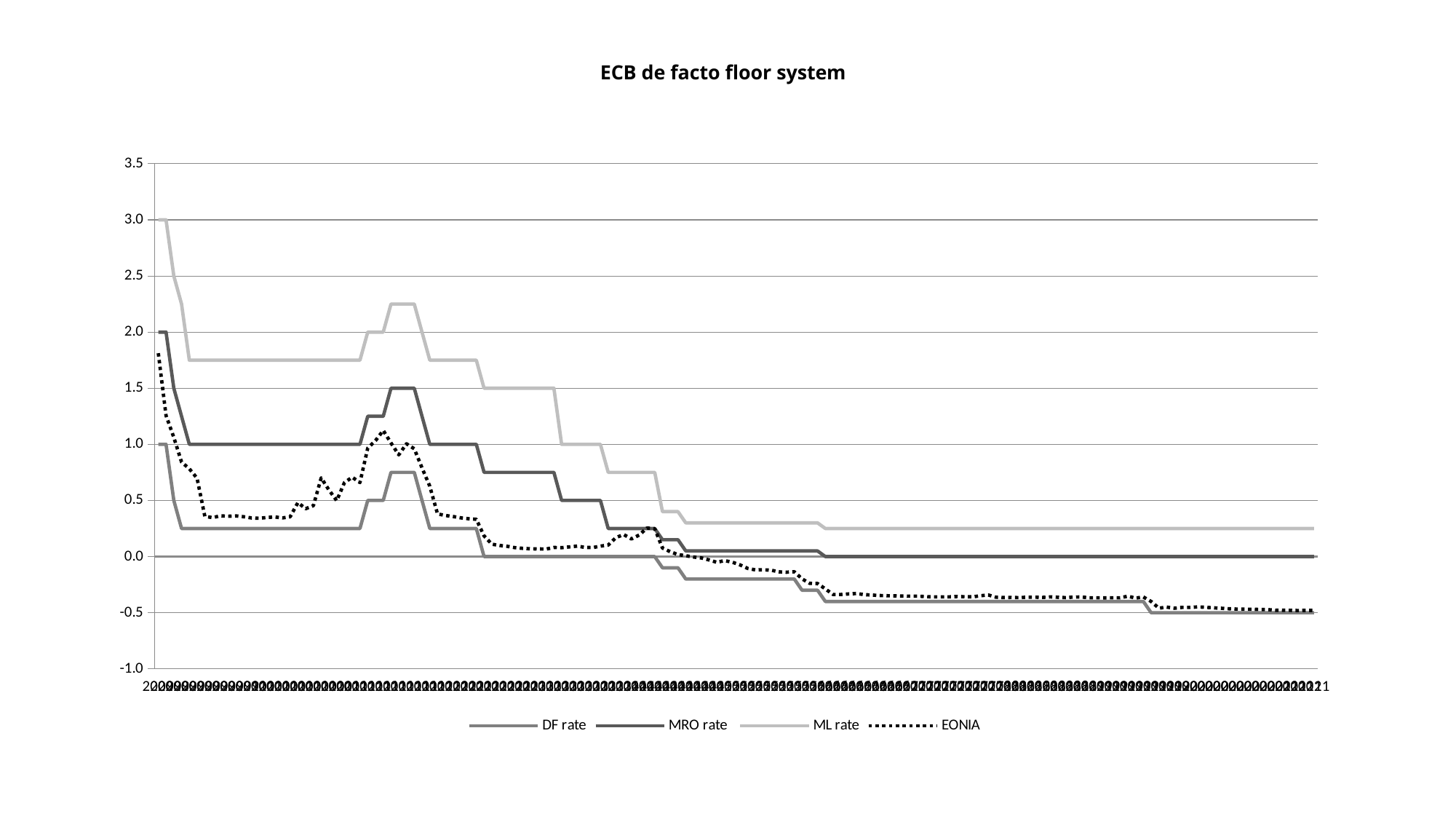
What is the title of the chart? ECB de facto floor system How many series does the legend list? 4 At the right edge of the chart, which is larger, the ML rate or the DF rate? ML rate Do the ML rate values rise or fall from left to right across the chart? fall At the left edge of the chart, which is larger, the ML rate or the MRO rate? ML rate What is the highest value shown on the vertical axis? 3.5 What kind of chart is shown on the slide? line chart Which series has the highest values across the chart? ML rate Is the ML rate at the right edge of the chart greater or less than 0.5? less Is the DF rate at the right edge of the chart greater or less than 0.0? less Which series is drawn with a dotted line? EONIA Is the ML rate at the left edge of the chart greater or less than 2.5? greater